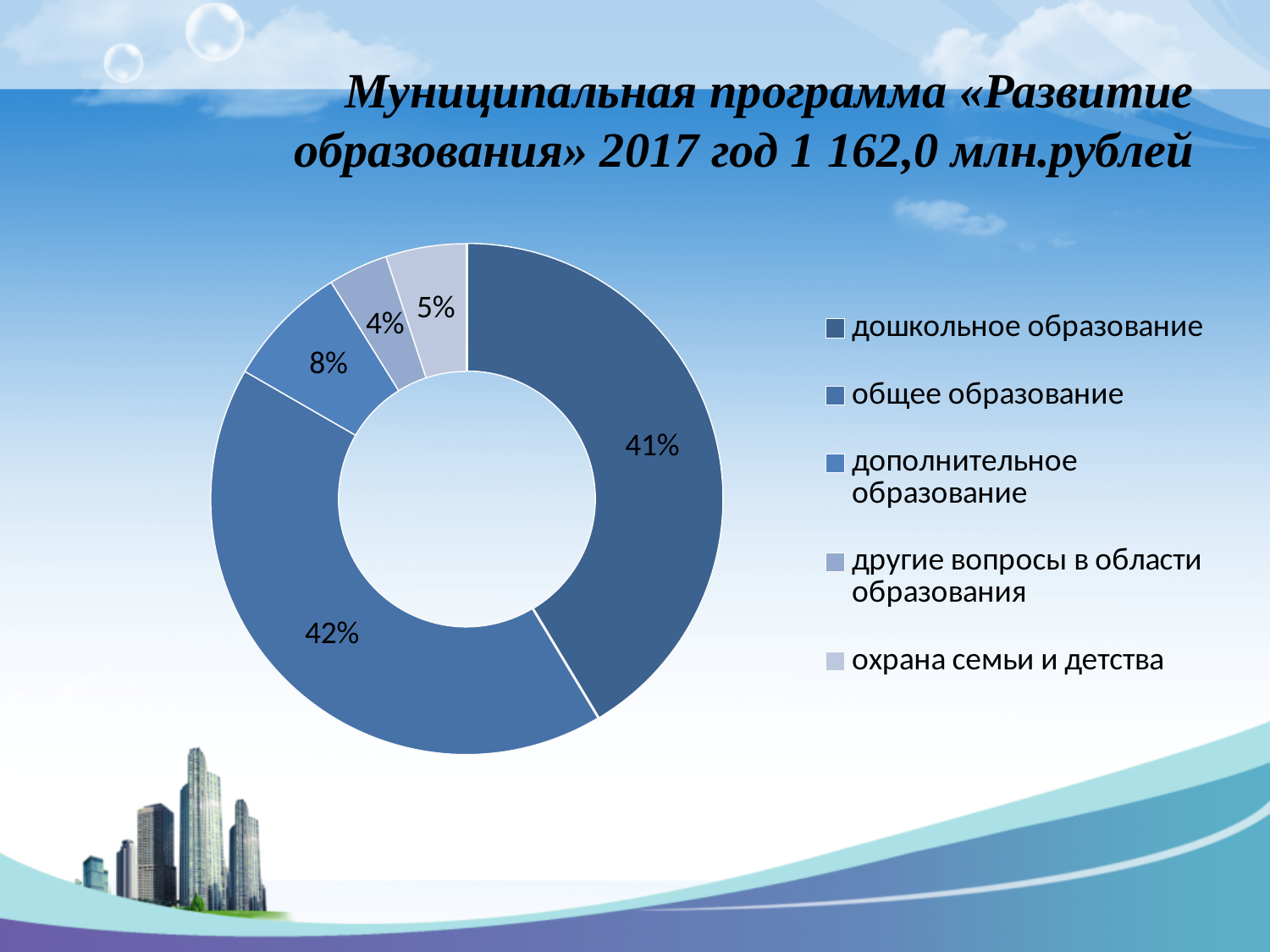
Which is larger: the share for охрана семьи и детства or the share for другие вопросы в области образования? охрана семьи и детства What share of the chart is дополнительное образование? 8% What share of the chart is охрана семьи и детства? 5% What share of the chart is другие вопросы в области образования? 4% How many categories does the legend list? 5 Which category has the largest share of the chart? общее образование Which category has the smallest share of the chart? другие вопросы в области образования What share of the chart is общее образование? 42% What is the title of the slide containing the chart? Муниципальная программа «Развитие образования» 2017 год 1 162,0 млн.рублей What is the difference in percentage points between общее образование and дополнительное образование? 34 What kind of chart is shown on the slide? Doughnut (pie) chart What share of the chart is дошкольное образование? 41%